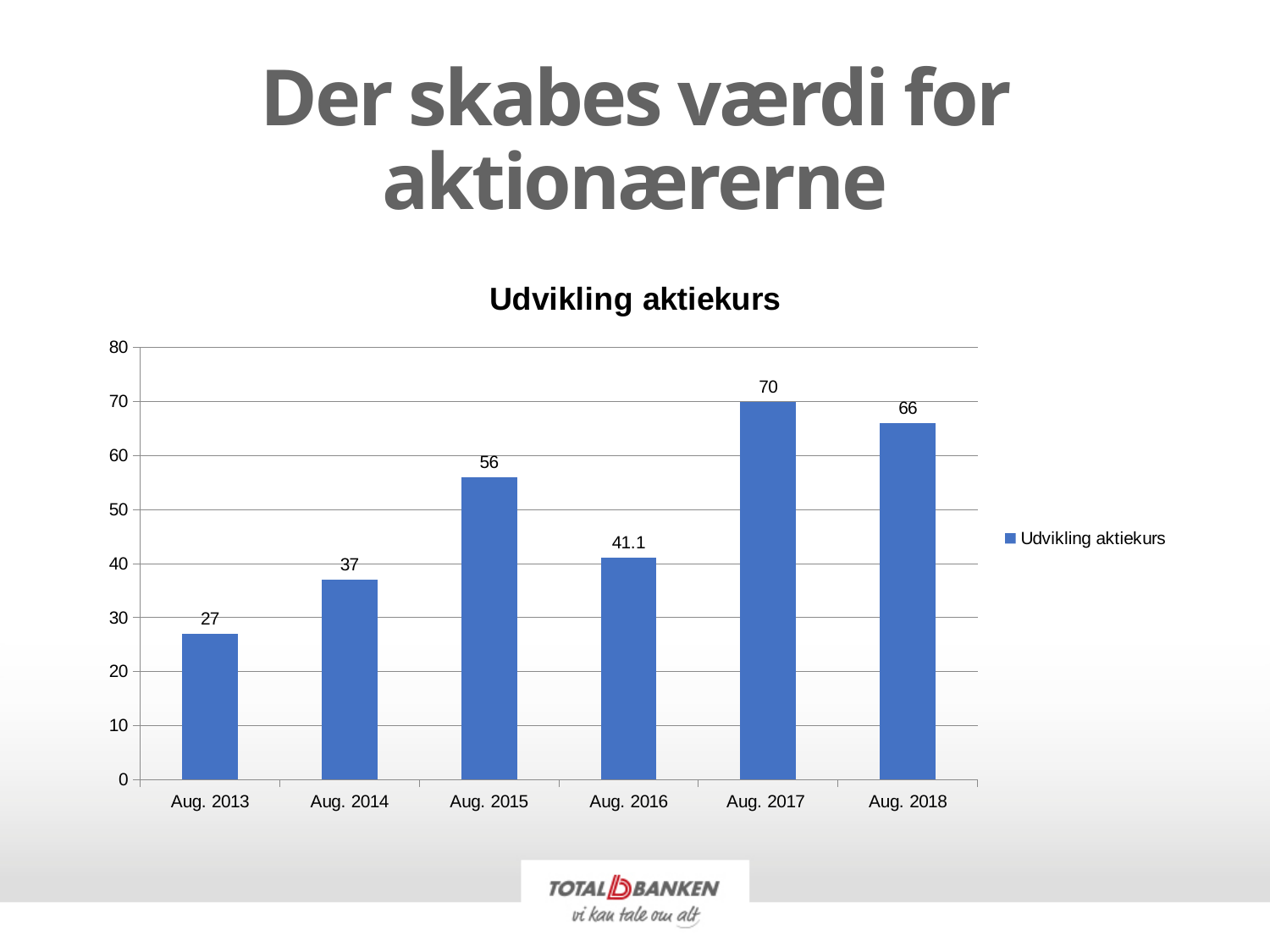
What is the difference between the values for Aug. 2017 and Aug. 2018? 4 How many categories are shown on the x axis? 6 Is the value for Aug. 2017 greater or less than 60? greater Which is larger, the value for Aug. 2015 or the value for Aug. 2016? Aug. 2015 What is the value for Aug. 2013? 27 What kind of chart is shown on the slide? bar chart What is the difference between the values for Aug. 2015 and Aug. 2014? 19 Which category has the highest value? Aug. 2017 What is the value for Aug. 2016? 41.1 Which category has the lowest value? Aug. 2013 What is the title of the chart? Udvikling aktiekurs What is the value for Aug. 2018? 66